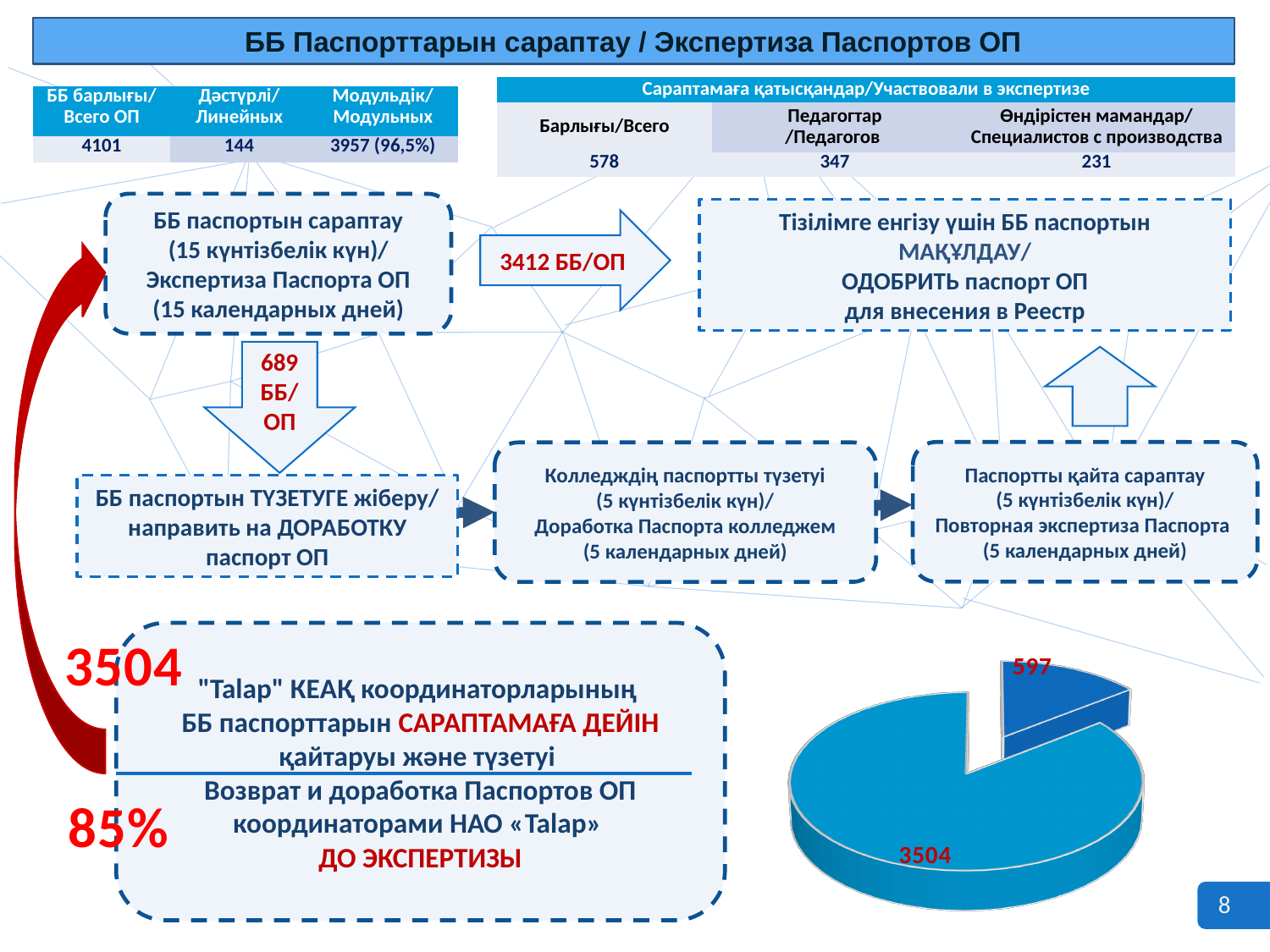
What is the value of the largest slice in the pie chart? 3504 How many slices does the pie chart at the bottom right have? 2 What colour is the small exploded slice of the pie chart? dark blue What kind of chart is shown at the bottom right of the slide? pie chart What is the difference between the two slice values in the pie chart (3504 and 597)? 2907 Is the value of the small slice in the pie chart greater or less than 1000? less What is the value of the smallest slice in the pie chart? 597 Which slice of the pie chart is larger, the one labelled 3504 or the one labelled 597? 3504 What is the total of the two slice values shown in the pie chart? 4101 What value is labelled on the small, separated (exploded) slice of the pie chart? 597 What share of the pie does the slice labelled 3504 represent, as shown on the slide? 85% What value is labelled on the large slice of the pie chart? 3504